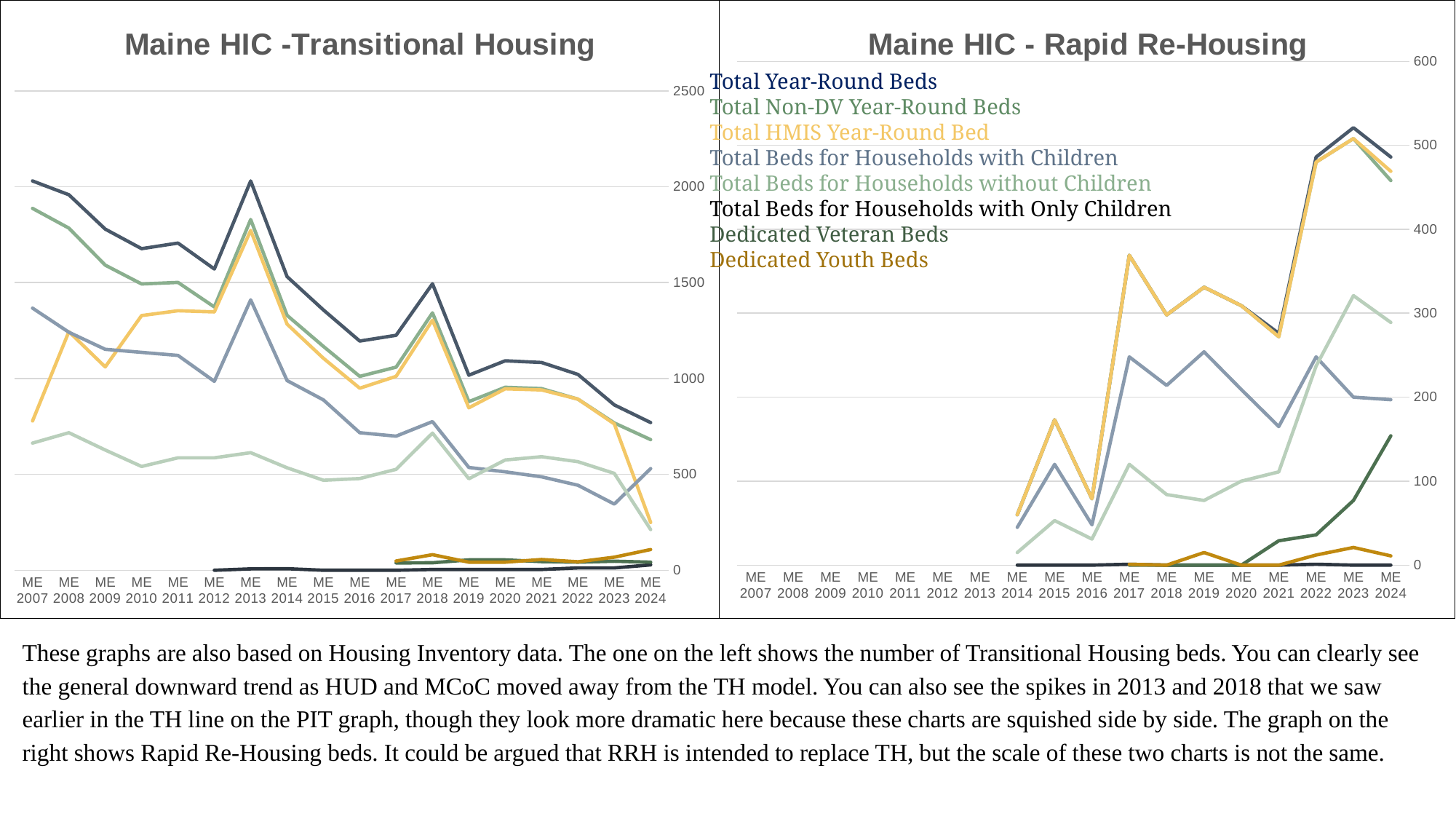
In the Maine HIC - Transitional Housing chart, is the value for Total Year-Round Beds in ME 2024 greater or less than 1000? less In the Maine HIC - Rapid Re-Housing chart, does Total Year-Round Beds generally rise or fall from 2014 to 2024? Rise What kind of chart is the Maine HIC - Transitional Housing chart? Line chart In the Maine HIC - Rapid Re-Housing chart, what is the first year for which data is plotted? ME 2014 In the Maine HIC - Rapid Re-Housing chart, is the value for Dedicated Veteran Beds in ME 2024 greater or less than 100? greater In the Maine HIC - Rapid Re-Housing chart, is the value for Total Year-Round Beds in ME 2023 greater or less than 500? greater In the Maine HIC - Rapid Re-Housing chart, in which year is Total Year-Round Beds highest? ME 2023 In the Maine HIC - Transitional Housing chart, is Total Year-Round Beds larger in ME 2013 or ME 2018? ME 2013 In the Maine HIC - Transitional Housing chart, in which year is Total Year-Round Beds lowest? ME 2024 In the Maine HIC - Transitional Housing chart, does Total Year-Round Beds generally rise or fall from 2007 to 2024? Fall How many years are shown on the x axis of the Maine HIC - Transitional Housing chart? 18 How many series does the legend list? 8